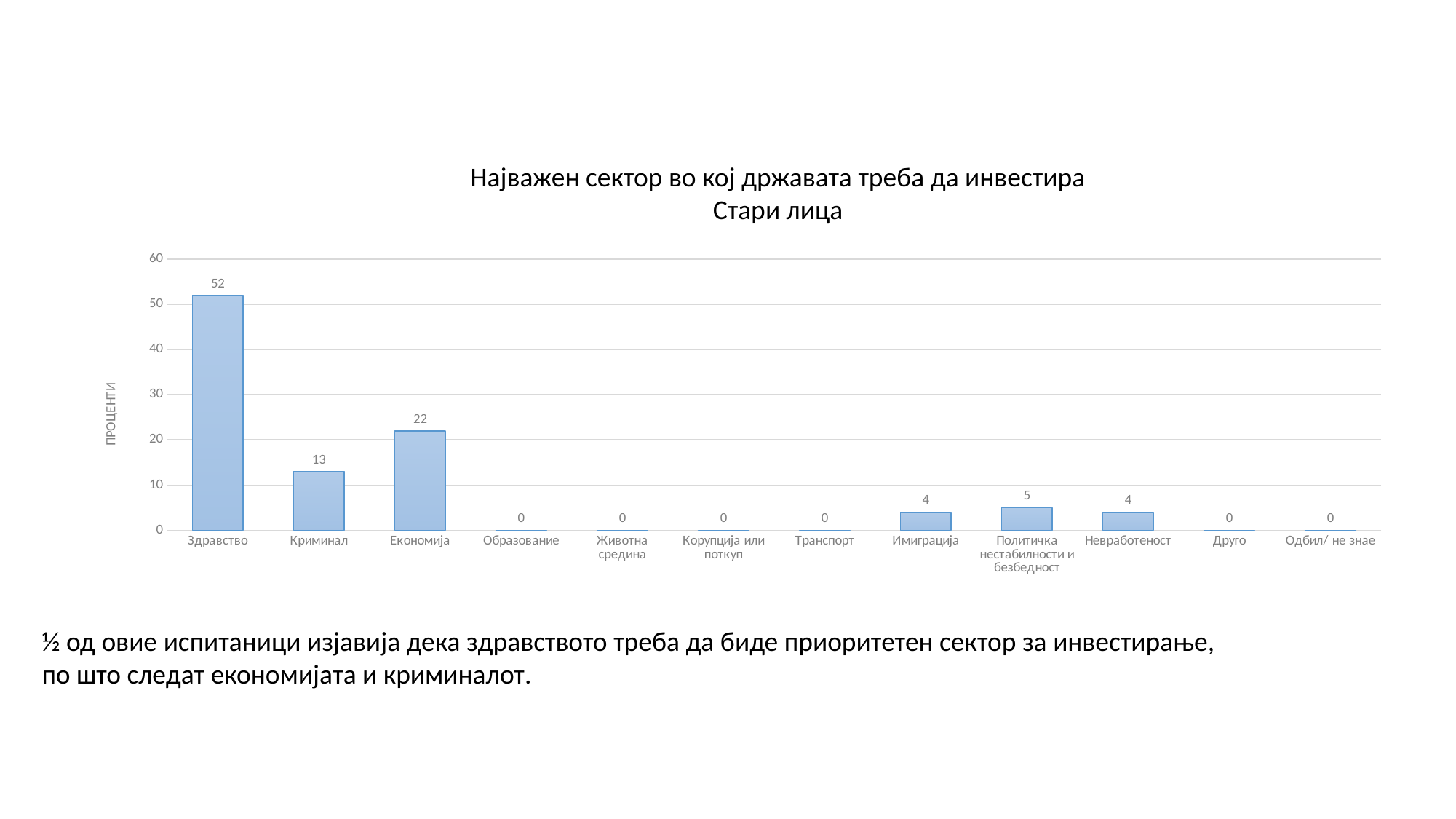
How many categories are shown on the x axis? 12 Which is larger, the value for Криминал or the value for Економија? Економија What kind of chart is shown on the slide? Bar chart What is the value for Политичка нестабилности и безбедност? 5 How many categories have a value of 0? 6 What is the value for Здравство? 52 What is the label of the vertical axis? ПРОЦЕНТИ Which category has the highest value? Здравство What is the difference between the values for Здравство and Економија? 30 Is the value for Здравство greater or less than 50? greater What is the value for Криминал? 13 What is the value for Економија? 22